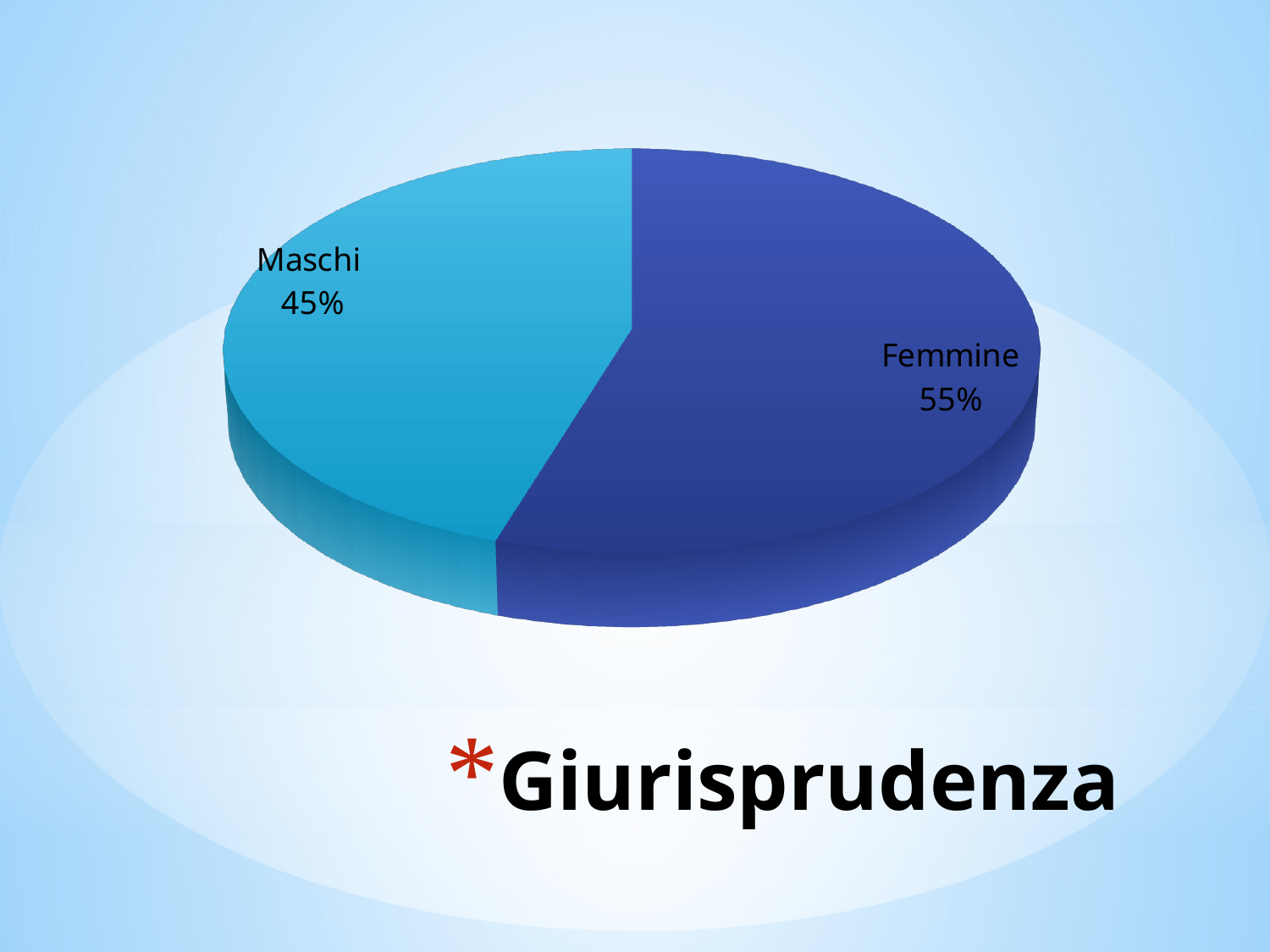
What kind of chart is shown on the slide? pie chart Which is larger, the share for Maschi or the share for Femmine? Femmine What percentage of the pie chart is Maschi? 45% What percentage of the pie chart is Femmine? 55% What is the difference in percentage points between Femmine and Maschi? 10 Which category has the largest share of the pie chart? Femmine What share of the pie does the Femmine slice represent? 55% What colour is the Maschi slice? light blue Is the share for Maschi greater or less than 50%? less What text appears below the chart on the slide? Giurisprudenza How many slices does the pie chart have? 2 Which category has the smallest share of the pie chart? Maschi